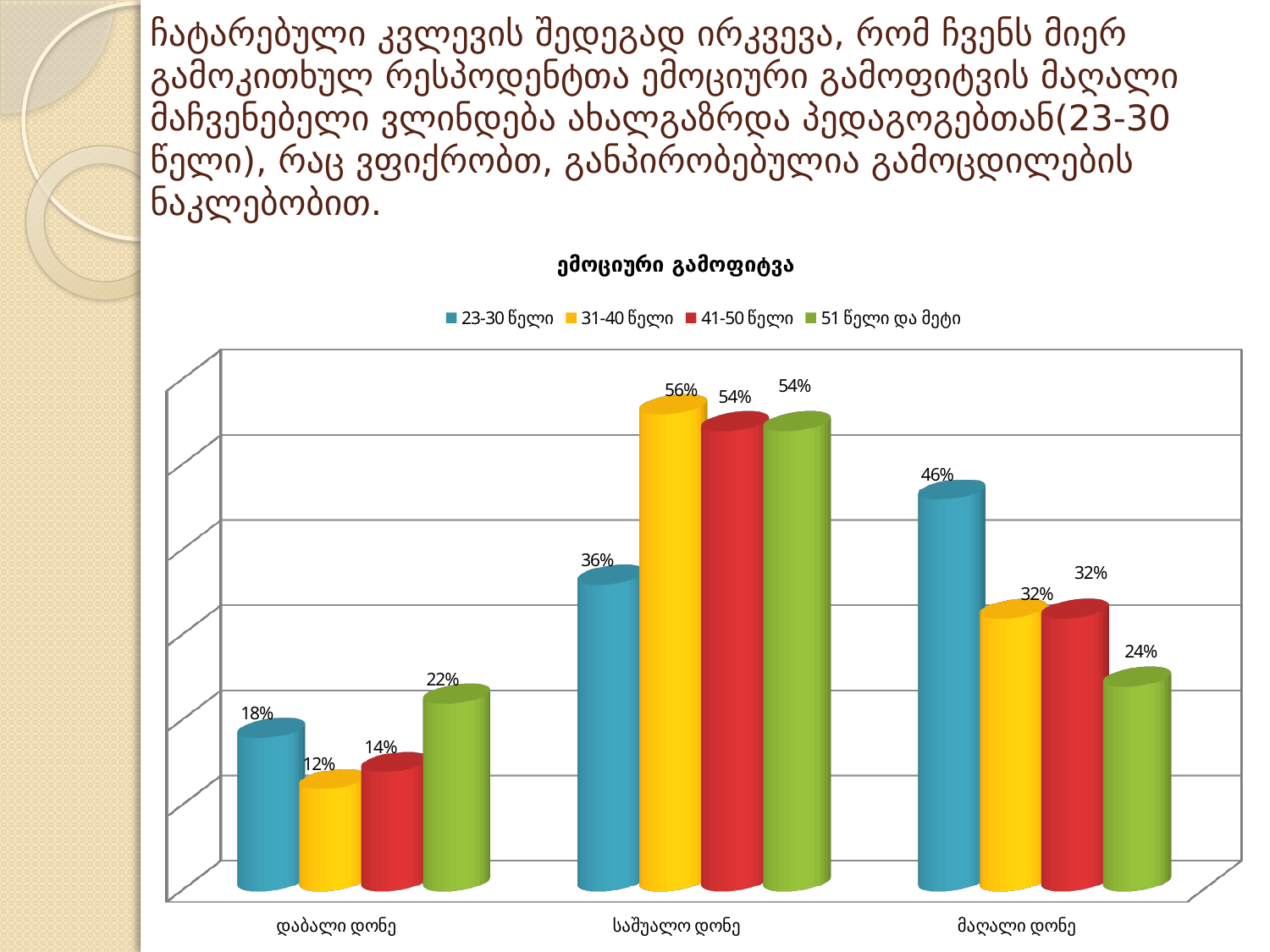
What is the title of the chart? ემოციური გამოფიტვა Which series has the highest value in the საშუალო დონე category? 31-40 წელი What is the difference between the 23-30 წელი and 51 წელი და მეტი values in the მაღალი დონე category? 22% In the დაბალი დონე category, which is larger: the value for 23-30 წელი or the value for 41-50 წელი? 23-30 წელი What is the difference between the 31-40 წელი and 23-30 წელი values in the საშუალო დონე category? 20% How many categories are shown on the x axis? 3 What is the value for 51 წელი და მეტი in the დაბალი დონე category? 22% Which series has the lowest value in the დაბალი დონე category? 31-40 წელი What is the value for 23-30 წელი in the მაღალი დონე category? 46% What type of chart is shown on the slide? bar chart How many series does the legend list? 4 What is the value for 31-40 წელი in the საშუალო დონე category? 56%